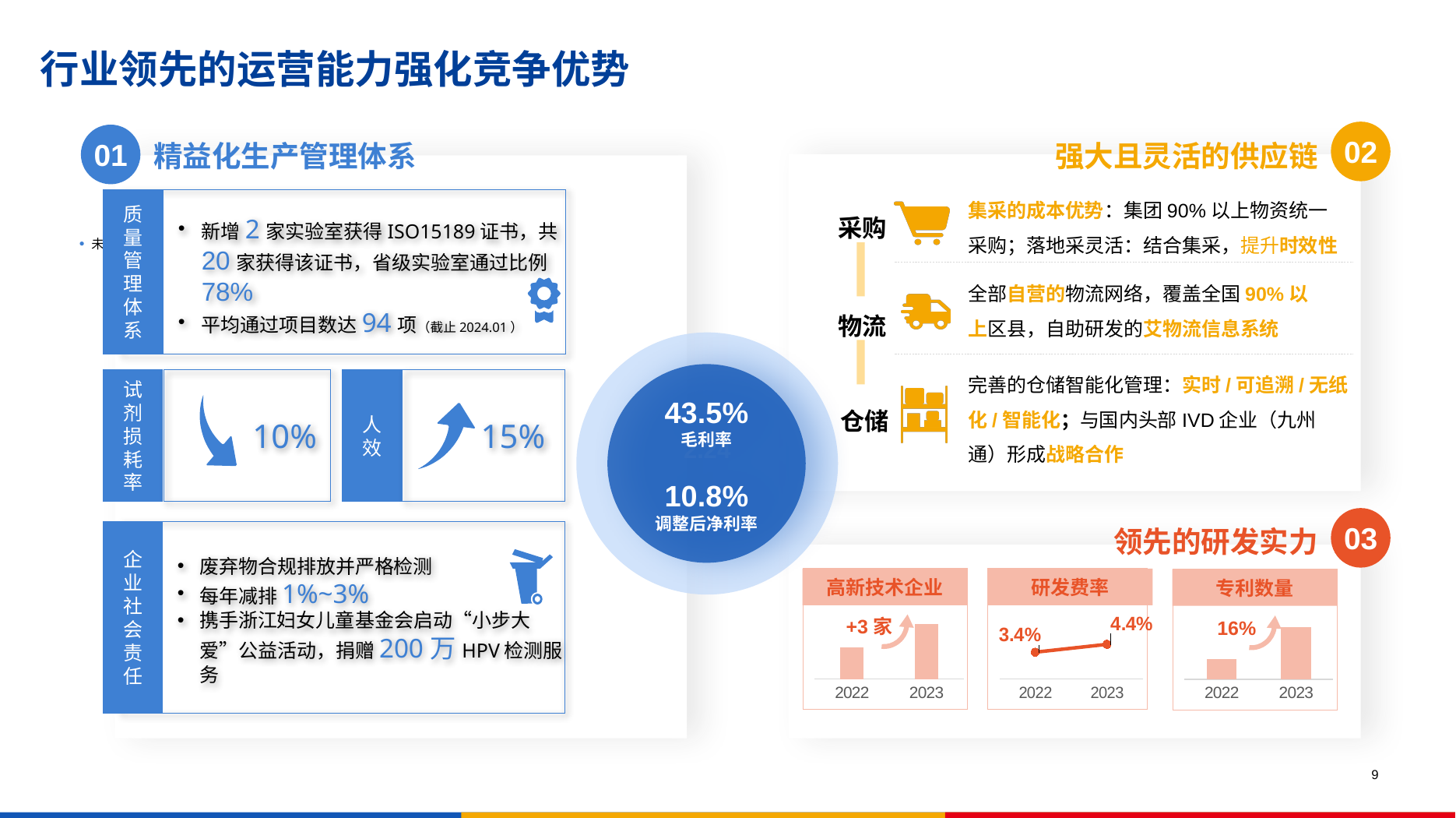
In the 研发费率 chart, what is the value for 2023? 4.4% In the 专利数量 chart, which year has the taller bar, 2022 or 2023? 2023 What kind of chart is the 高新技术企业 chart? bar chart In the 研发费率 chart, what is the difference between the 2023 and 2022 values? 1.0% What kind of chart is the 专利数量 chart? bar chart In the 研发费率 chart, what is the value for 2022? 3.4% What kind of chart is the 研发费率 chart? line chart How many years are shown on the x axis of the 高新技术企业 chart? 2 What change label is printed above the bars in the 高新技术企业 chart? +3 家 In the 专利数量 chart, does the value rise or fall from 2022 to 2023? rise In the 研发费率 chart, which year has the higher value, 2022 or 2023? 2023 In the 高新技术企业 chart, does the value rise or fall from 2022 to 2023? rise